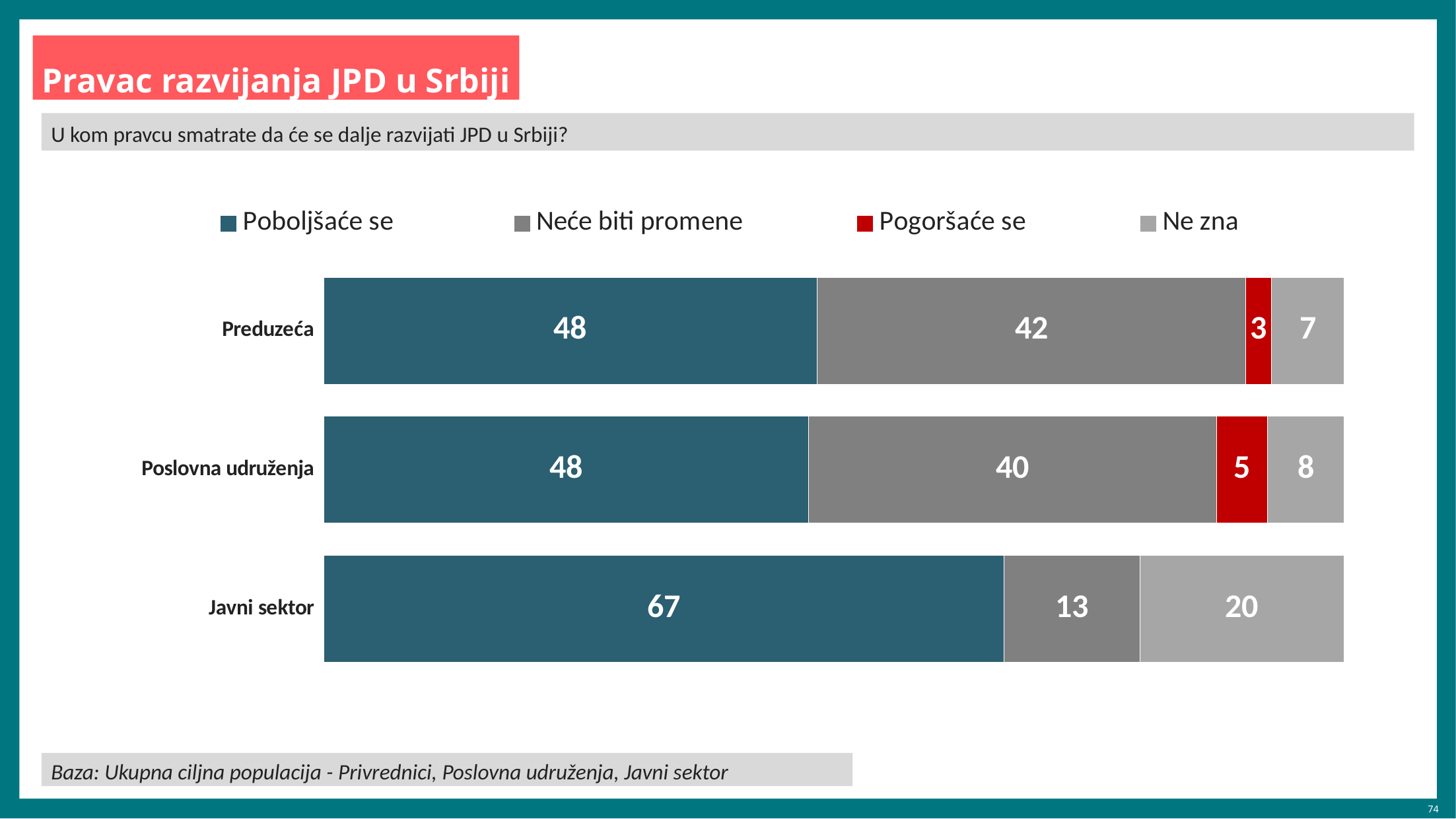
Which is larger: the "Ne zna" value for Poslovna udruženja or for Preduzeća? Poslovna udruženja Which category has the highest value for "Poboljšaće se"? Javni sektor How many categories are shown on the chart? 3 What is the value of "Poboljšaće se" for Javni sektor? 67 What kind of chart is shown on the slide? Stacked bar chart What is the value of "Pogoršaće se" for Poslovna udruženja? 5 Which legend entry is shown in red? Pogoršaće se Which category has the lowest value for "Neće biti promene"? Javni sektor How many series does the legend list? 4 What is the difference between the "Poboljšaće se" values for Javni sektor and Preduzeća? 19 What is the value of "Ne zna" for Javni sektor? 20 What is the value of "Neće biti promene" for Preduzeća? 42